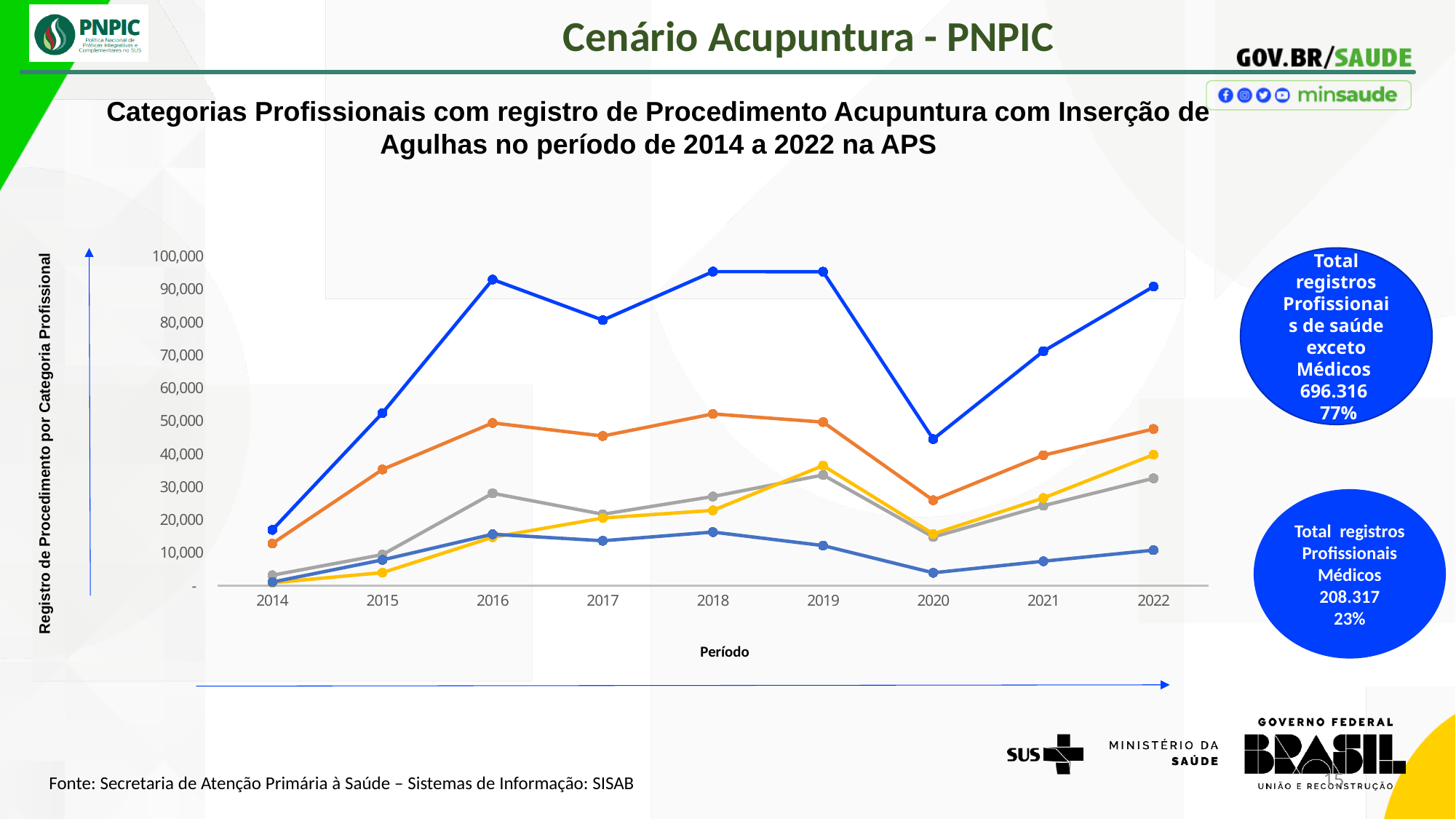
In which year does the topmost line reach its lowest value? 2014 Is the highest value plotted for 2016 greater or less than 90,000? greater Is the highest value plotted for 2022 greater or less than 80,000? greater What kind of chart is shown on the slide? line chart How many years are shown on the x axis of the chart? 9 Is the highest value plotted for 2014 greater or less than 20,000? less What is the label of the y axis of the chart? Registro de Procedimento por Categoria Profissional How many lines are plotted on the chart? 5 What is the title of the x axis of the chart? Período